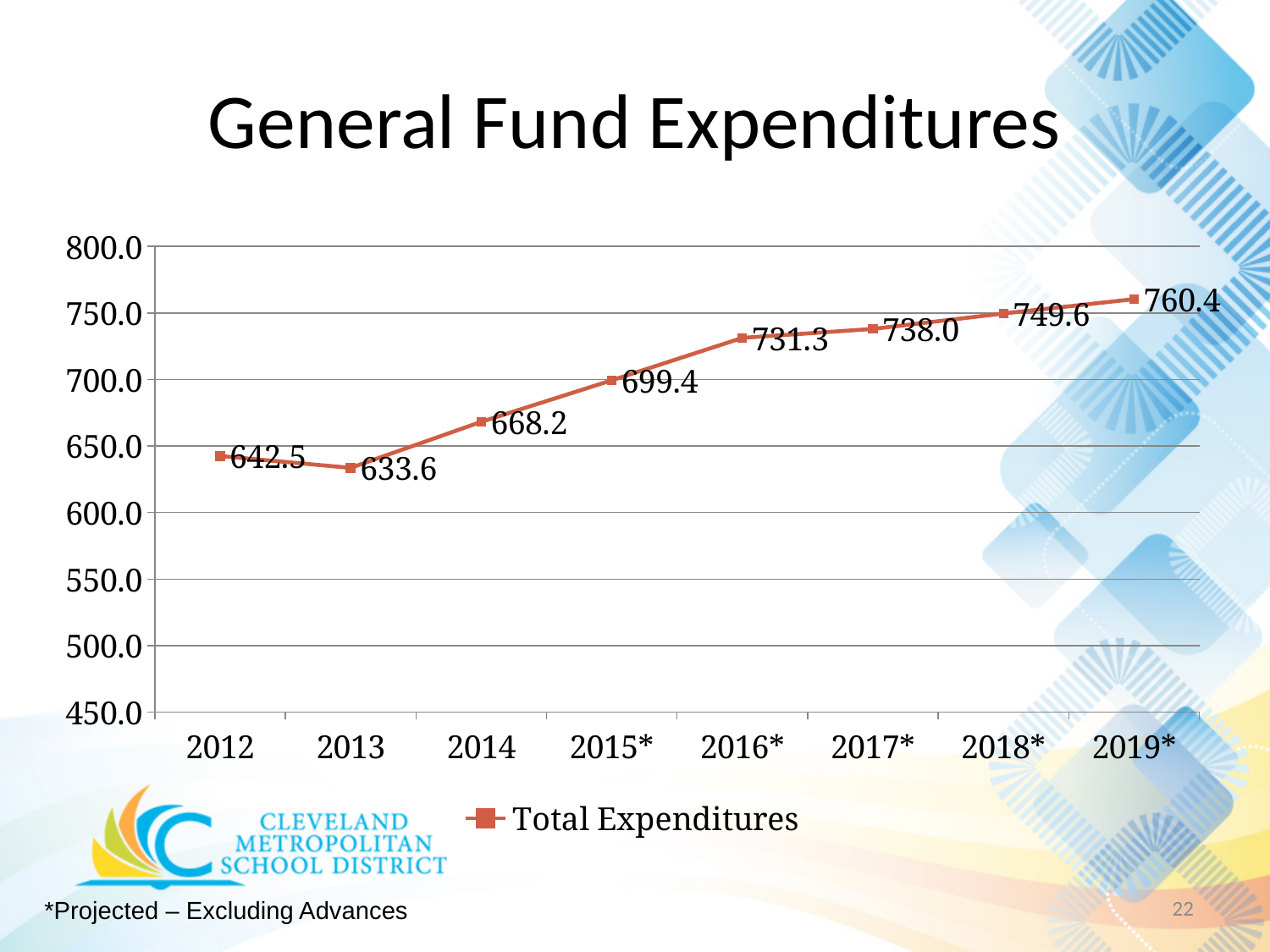
Is the value for 2015* greater or less than 650.0? greater What is the difference between Total Expenditures in 2019* and 2012? 117.9 What is the difference between Total Expenditures in 2014 and 2013? 34.6 What kind of chart is shown on the slide? line chart Which is larger, Total Expenditures in 2015* or in 2017*? 2017* What is the value of Total Expenditures for 2019*? 760.4 What is the title of the chart? General Fund Expenditures How many years are plotted on the chart? 8 What is the value of Total Expenditures for 2016*? 731.3 Which year has the highest Total Expenditures? 2019* What is the value of Total Expenditures for 2012? 642.5 Which year has the lowest Total Expenditures? 2013